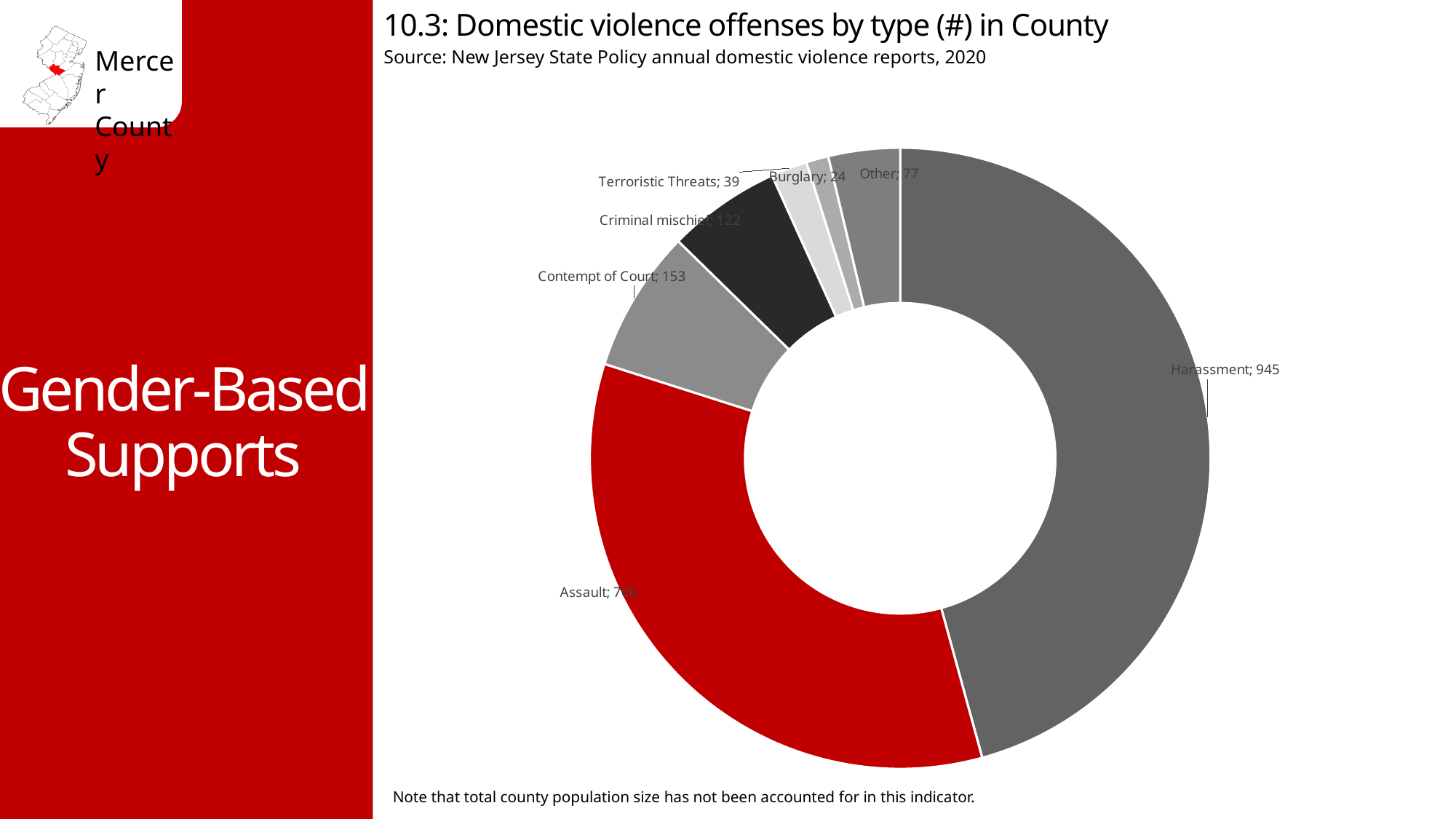
What kind of chart is shown on the slide? doughnut chart How many domestic violence offenses of type Harassment are shown? 945 How many offense types are shown in the chart? 7 What is the value for Terroristic Threats? 39 What is the difference between the Harassment and Contempt of Court values? 792 Which offense type has the highest number of offenses? Harassment What is the value for Burglary? 24 What is the value for Criminal mischief? 122 Which offense type has the lowest number of offenses? Burglary What is the value for Other? 77 What is the value for Contempt of Court? 153 Which is larger, Contempt of Court or Criminal mischief? Contempt of Court